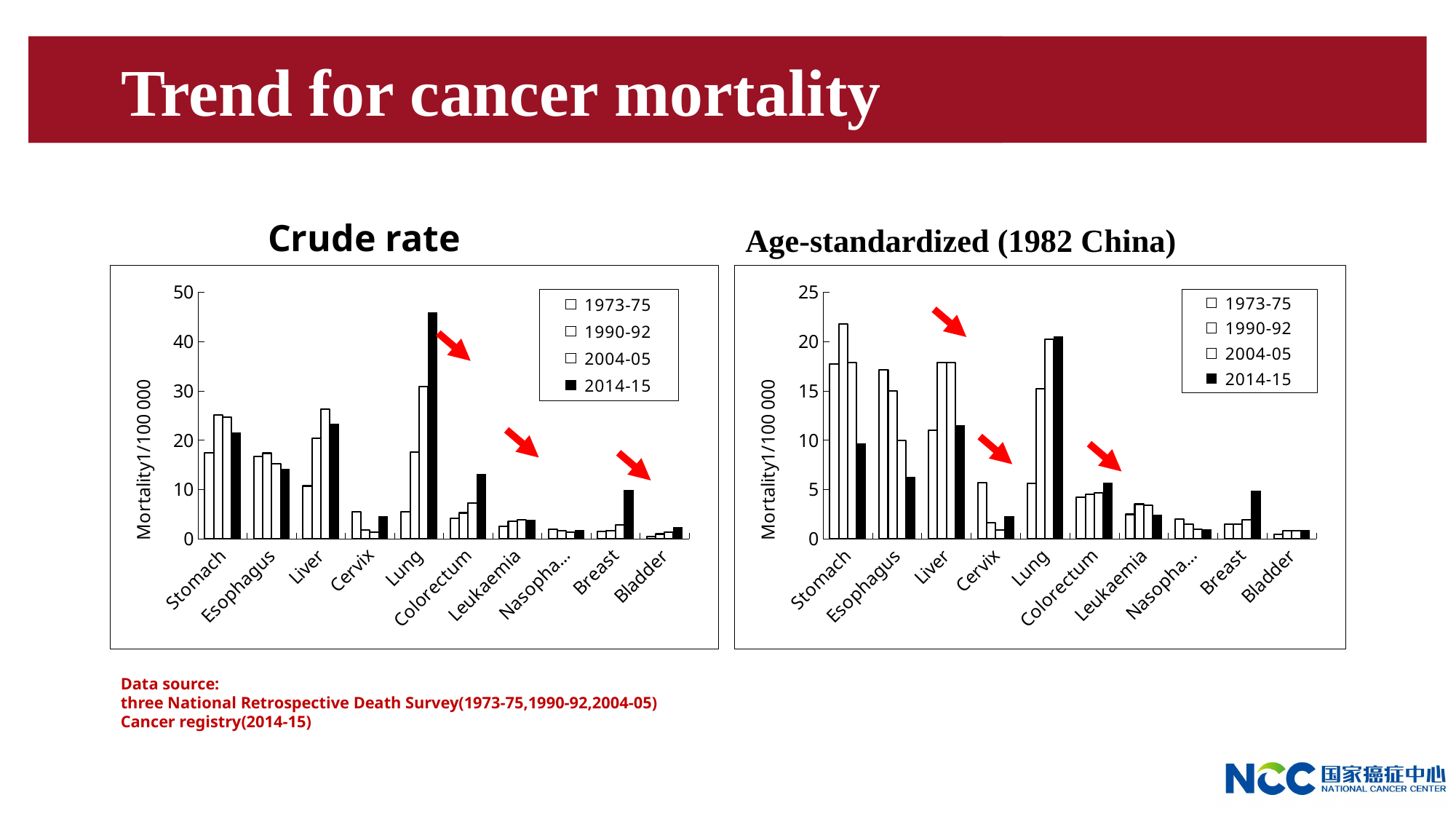
In the Crude rate chart, is the 2014-15 value for Cervix greater or less than 10? less In the Age-standardized (1982 China) chart, is the 1990-92 value for Stomach greater or less than 20? greater In the Age-standardized (1982 China) chart, does the Esophagus value rise or fall across the four periods from 1973-75 to 2014-15? fall In the Age-standardized (1982 China) chart, which category has the highest 2014-15 value? Lung In the Age-standardized (1982 China) chart, which is larger for 2014-15: Stomach or Esophagus? Stomach How many series does the legend of the Age-standardized (1982 China) chart list? 4 In the Crude rate chart, is the 2014-15 value for Colorectum greater or less than 10? greater In the Crude rate chart, which category has the highest 2014-15 value? Lung How many cancer categories are shown on the x axis of the Crude rate chart? 10 In the Crude rate chart, does the Lung value rise or fall across the four periods from 1973-75 to 2014-15? rise What kind of chart is the Crude rate chart? bar chart